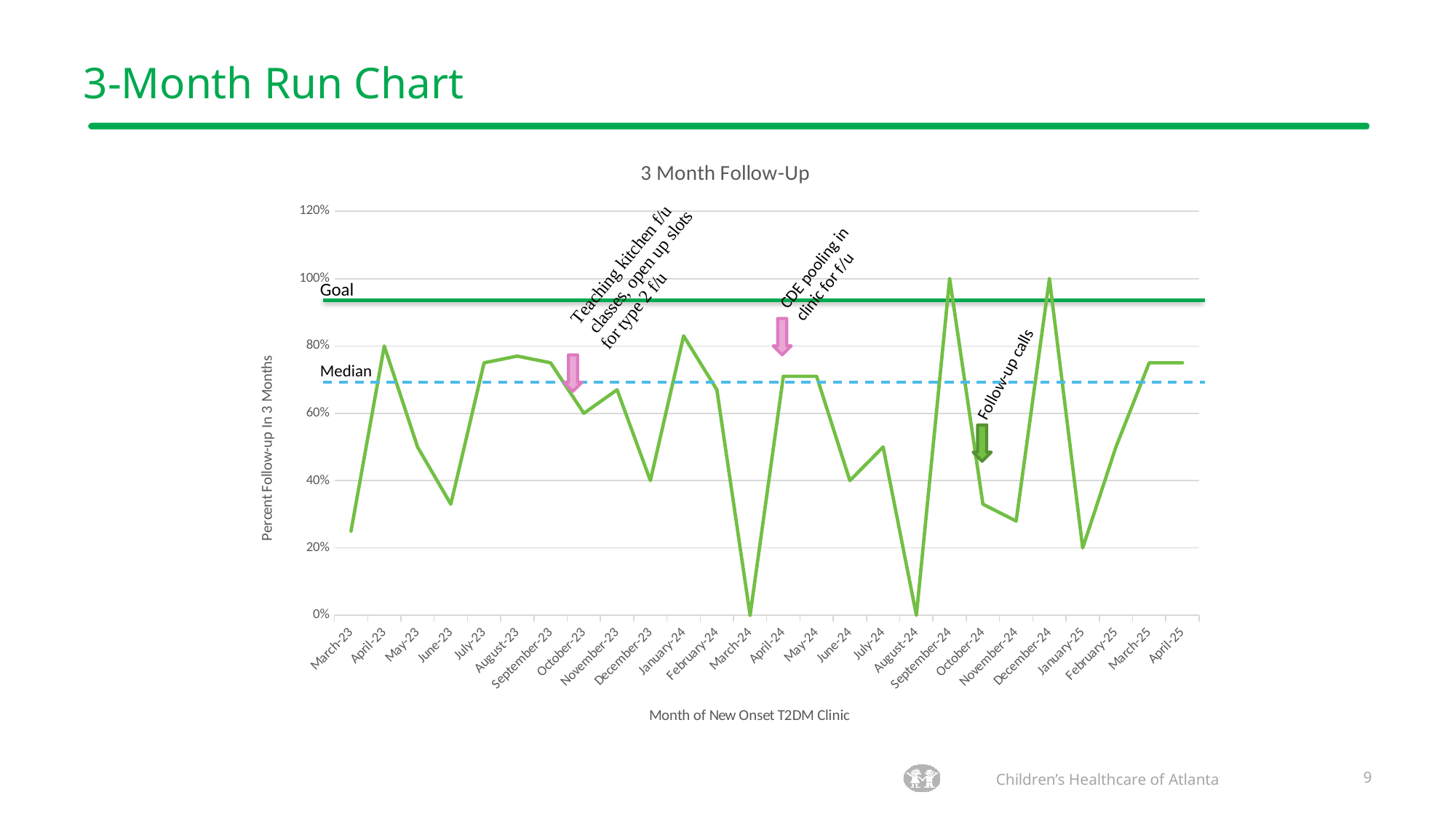
Is the value for March-23 greater or less than 40%? less Which is larger, the value for April-23 or the value for June-23? April-23 What is the difference between the values for December-24 and January-25? 80% What is the value for September-24? 100% How many months are plotted along the x axis? 26 What is the value for March-24? 0% What type of chart is shown on the slide? line chart What is the x-axis title of the chart? Month of New Onset T2DM Clinic Is the value for January-24 greater or less than 80%? greater Which month has the lowest value, March-24 or April-24? March-24 What is the value for January-25? 20% What is the title of the chart? 3 Month Follow-Up